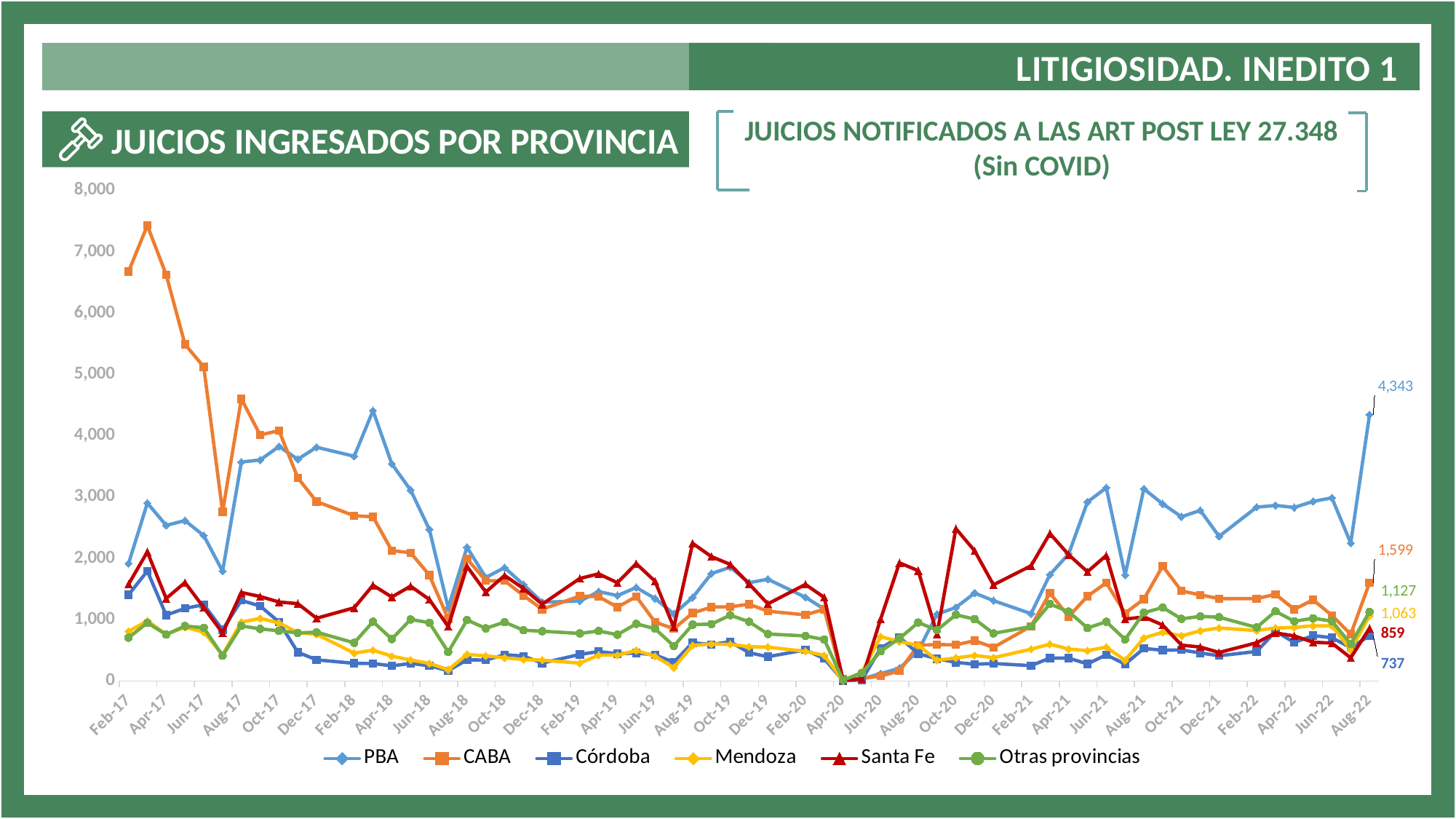
What is the difference between the PBA and CABA values at Aug-22? 2,744 Which series has the highest value at Aug-22? PBA What is the value for Córdoba at Aug-22? 737 What is the title of the chart? JUICIOS INGRESADOS POR PROVINCIA What is the value for CABA at Aug-22? 1,599 What type of chart is shown on the slide? line chart At Aug-22, which is larger: the value for Mendoza or the value for Santa Fe? Mendoza What is the value for PBA at Aug-22? 4,343 How many series does the legend list? 6 Which series has the lowest value at Aug-22? Córdoba What is the value for Santa Fe at Aug-22? 859